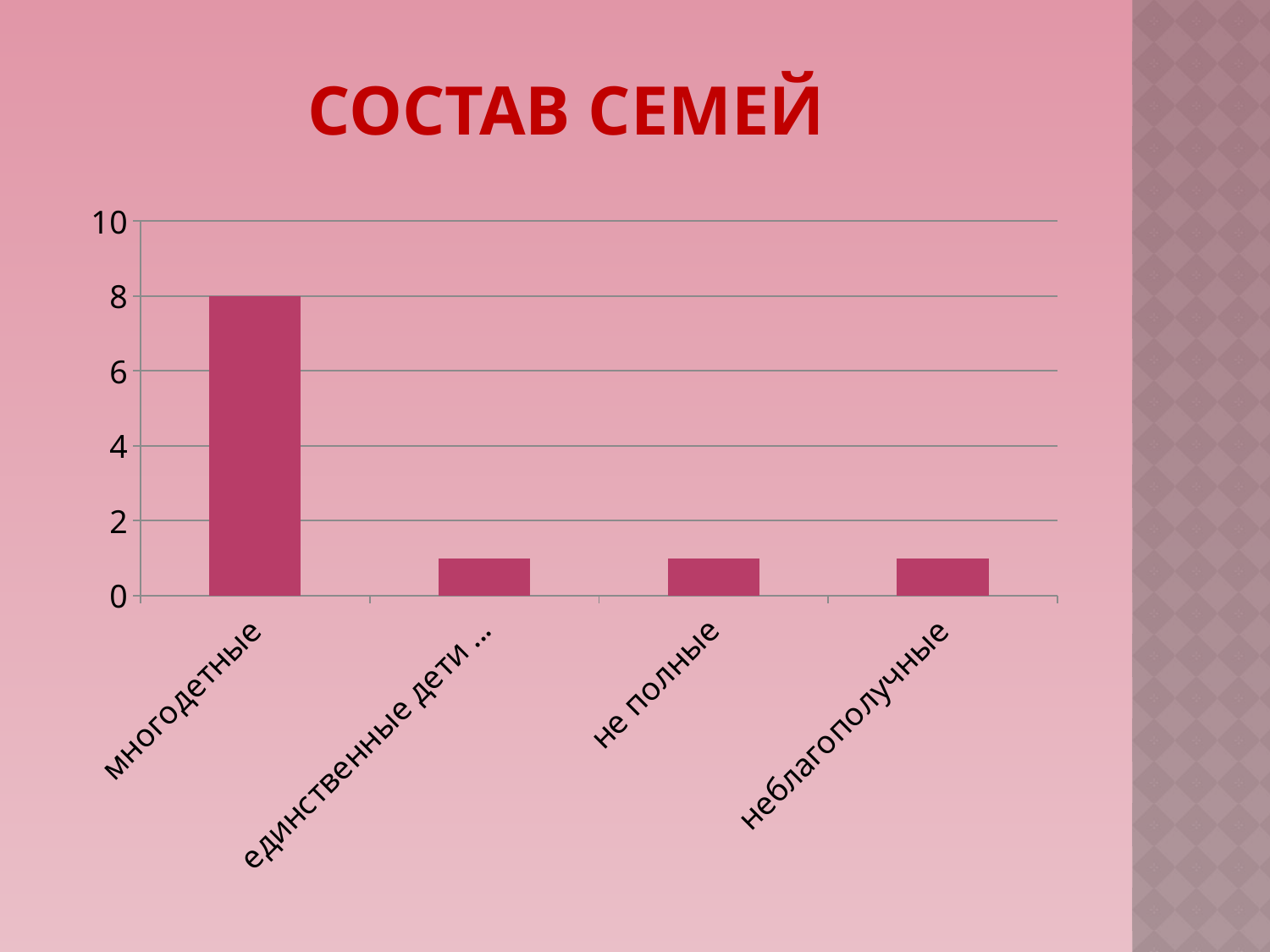
Which is larger, the value for многодетные or the value for не полные? многодетные What kind of chart is shown on the slide? bar chart What is the highest value shown on the vertical axis? 10 How many categories are shown on the x axis? 4 Is the value for неблагополучные greater or less than 2? less Is the value for не полные greater or less than 2? less What is the value for многодетные? 8 What is the title of the slide? СОСТАВ СЕМЕЙ Which category has the highest value? многодетные Which is larger, the value for неблагополучные or the value for многодетные? многодетные Is the value for многодетные greater or less than 6? greater